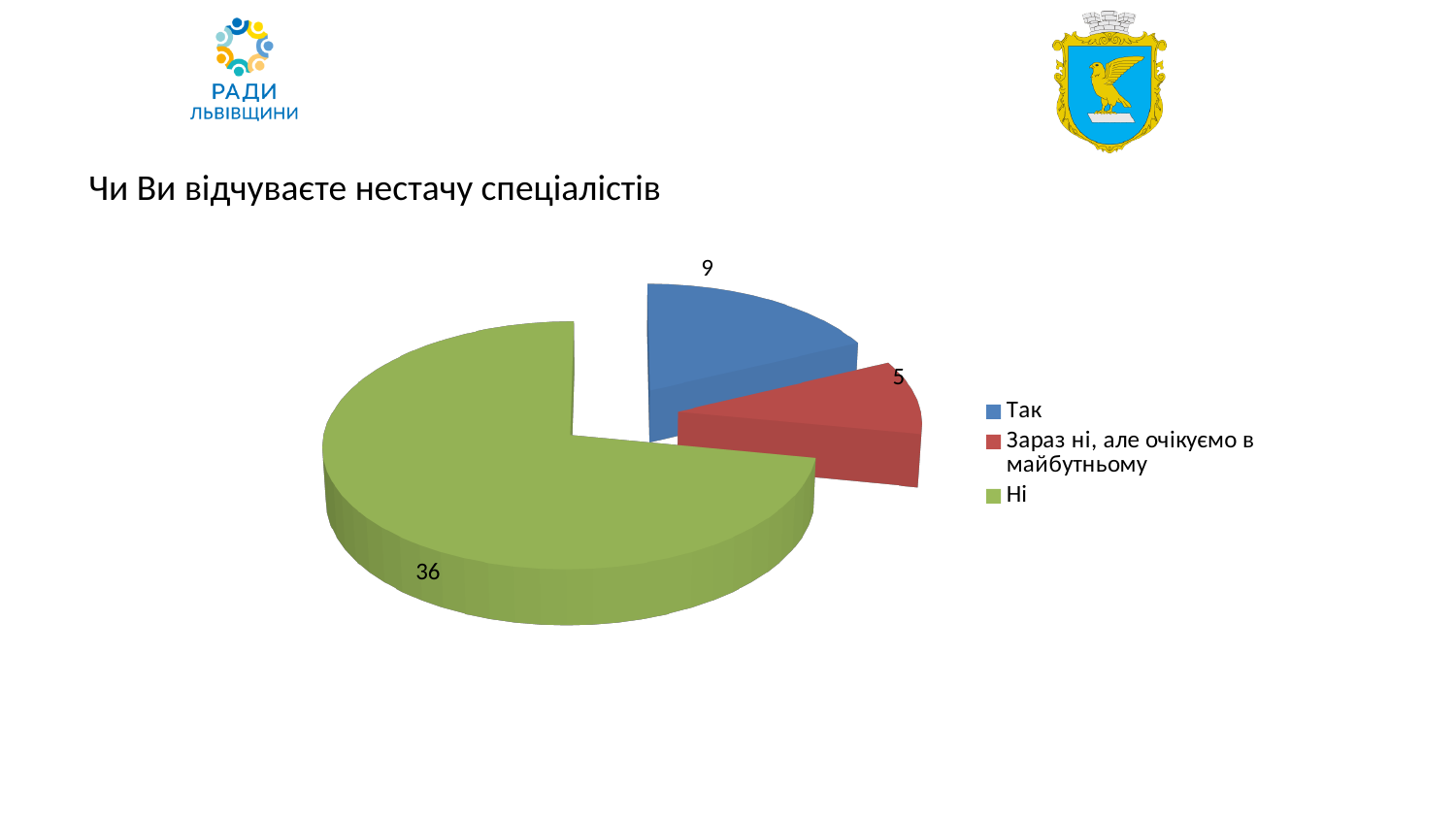
How many slices does the pie chart have? 3 What is the difference between the values for "Ні" and "Так"? 27 What is the value for "Зараз ні, але очікуємо в майбутньому"? 5 Which category has the smallest slice? Зараз ні, але очікуємо в майбутньому What share of the pie does the "Ні" slice represent? 72% Which category has the largest slice? Ні What is the title of the chart? Чи Ви відчуваєте нестачу спеціалістів Which is larger, the value for "Так" or the value for "Зараз ні, але очікуємо в майбутньому"? Так What is the value for "Так"? 9 What type of chart is shown on the slide? pie chart What is the total of all slices in the pie chart? 50 What is the value for "Ні"? 36